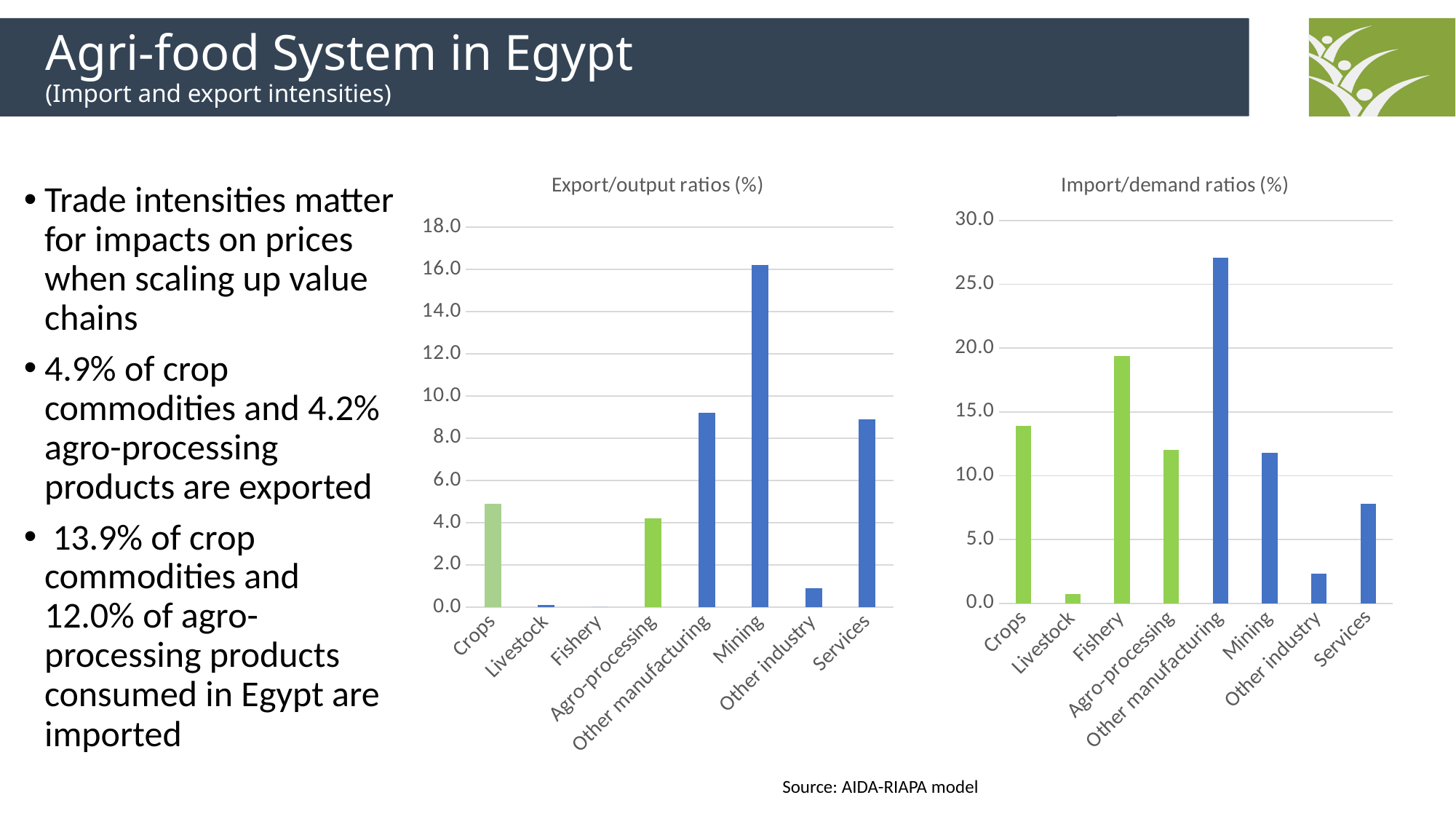
On the Export/output ratios (%) chart, is the value for Mining greater or less than 14.0? greater On the Import/demand ratios (%) chart, which category has the lowest value? Livestock On the Import/demand ratios (%) chart, is the value for Fishery greater or less than 15.0? greater On the Import/demand ratios (%) chart, which category has the highest value? Other manufacturing How many categories are shown on the Import/demand ratios (%) chart? 8 On the Import/demand ratios (%) chart, which is larger, Fishery or Agro-processing? Fishery What kind of chart is the Export/output ratios (%) chart? bar chart What is the title of the chart on the right side of the slide? Import/demand ratios (%) On the Export/output ratios (%) chart, which category has the highest value? Mining On the Export/output ratios (%) chart, which is larger, Mining or Services? Mining On the Export/output ratios (%) chart, is the value for Services greater or less than 10.0? less